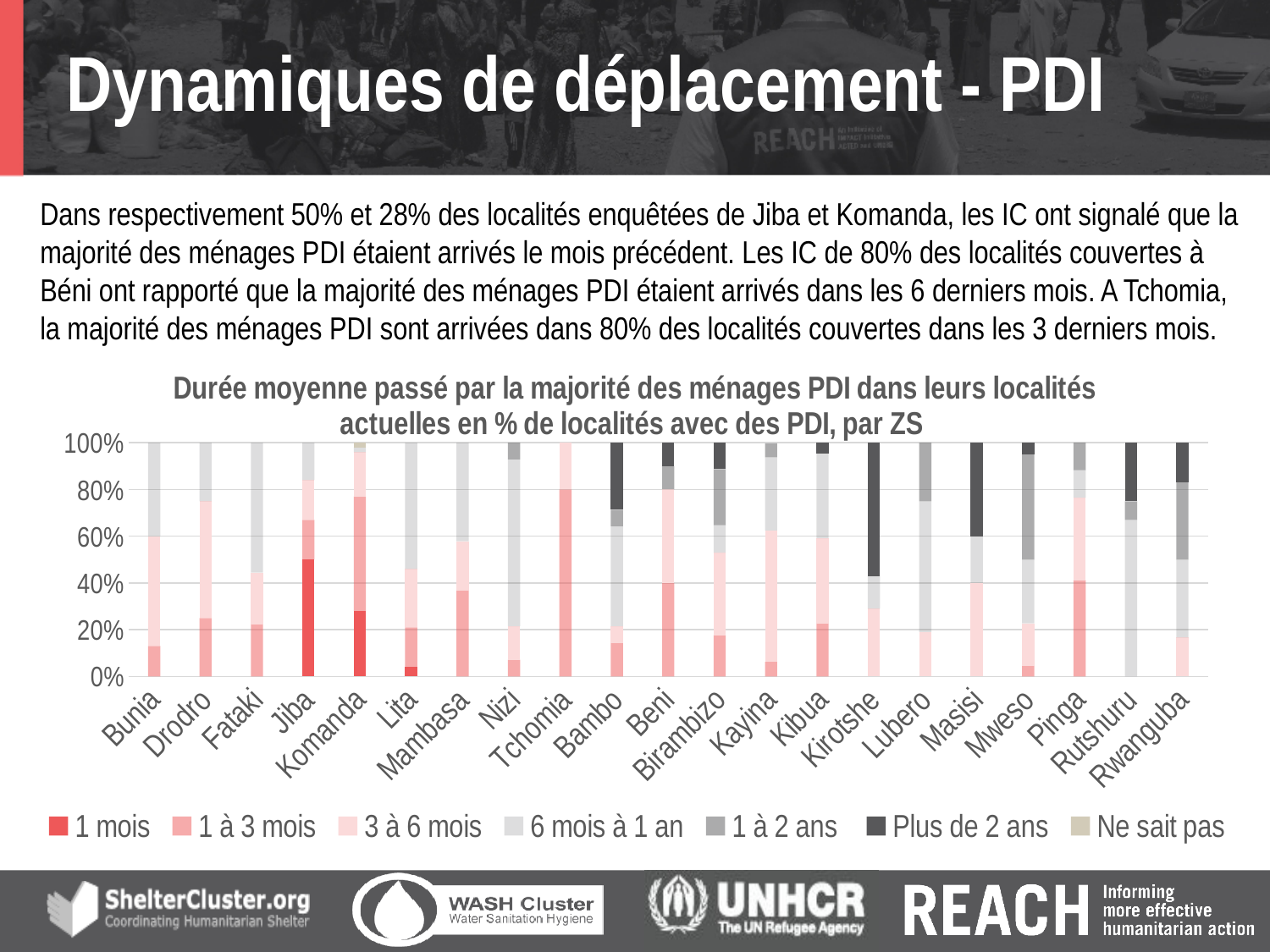
What kind of chart is shown on the slide? stacked bar chart Is the '1 à 3 mois' segment for Tchomia greater or less than 60%? greater Which category has the largest 'Plus de 2 ans' segment? Kirotshe Which legend entry is listed first in the chart legend? 1 mois What is the total height of the stacked bar for Bunia? 100% Is the '1 à 3 mois' segment for Bunia greater or less than 20%? less Is the '1 mois' segment for Jiba greater or less than 40%? greater Which is larger: the '1 mois' segment for Jiba or the '1 mois' segment for Komanda? Jiba How many series does the chart legend list? 7 How many zones de santé (categories) are shown on the x axis of the chart? 21 Which category has the largest '1 mois' segment? Jiba Which category has the largest '1 à 3 mois' segment? Tchomia